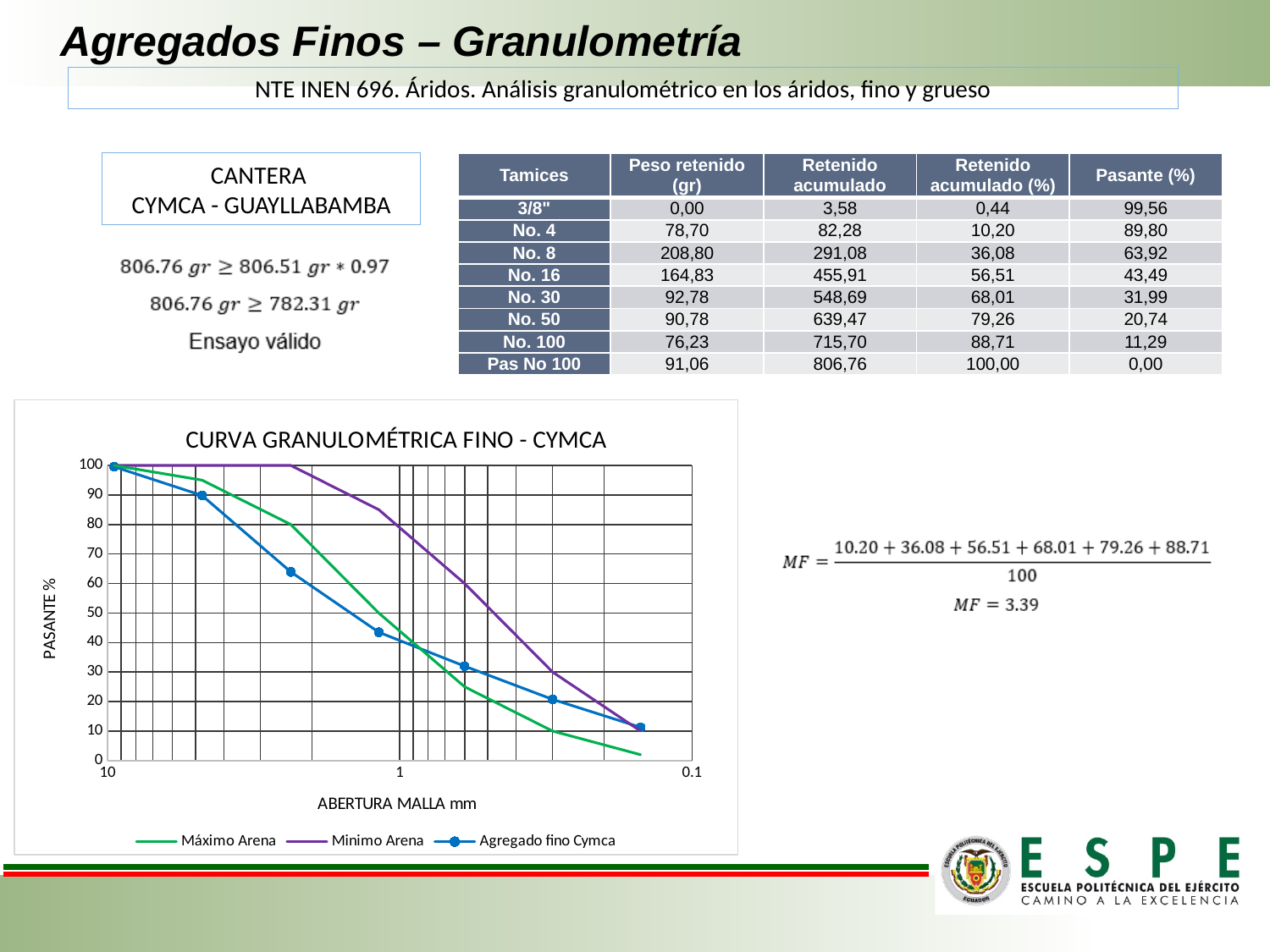
How many series does the legend of the chart list? 3 At an opening of 0.3 mm, which series has the higher value: Máximo Arena or Minimo Arena? Minimo Arena What kind of chart is shown on the slide? line chart How many marked data points does the Agregado fino Cymca series show on the chart? 7 What is the title of the chart? CURVA GRANULOMÉTRICA FINO - CYMCA Is the value of Agregado fino Cymca at an opening of 10 mm greater or less than 90? greater Is the value of Máximo Arena at an opening of 0.3 mm greater or less than 20? less What is the label of the x axis of the chart? ABERTURA MALLA mm At an opening of 1 mm, which series has the higher value: Minimo Arena or Agregado fino Cymca? Minimo Arena Is the value of Minimo Arena at an opening of 1 mm greater or less than 60? greater Do the values of Agregado fino Cymca rise or fall as the mesh opening goes from 10 mm to 0.1 mm along the x axis? fall